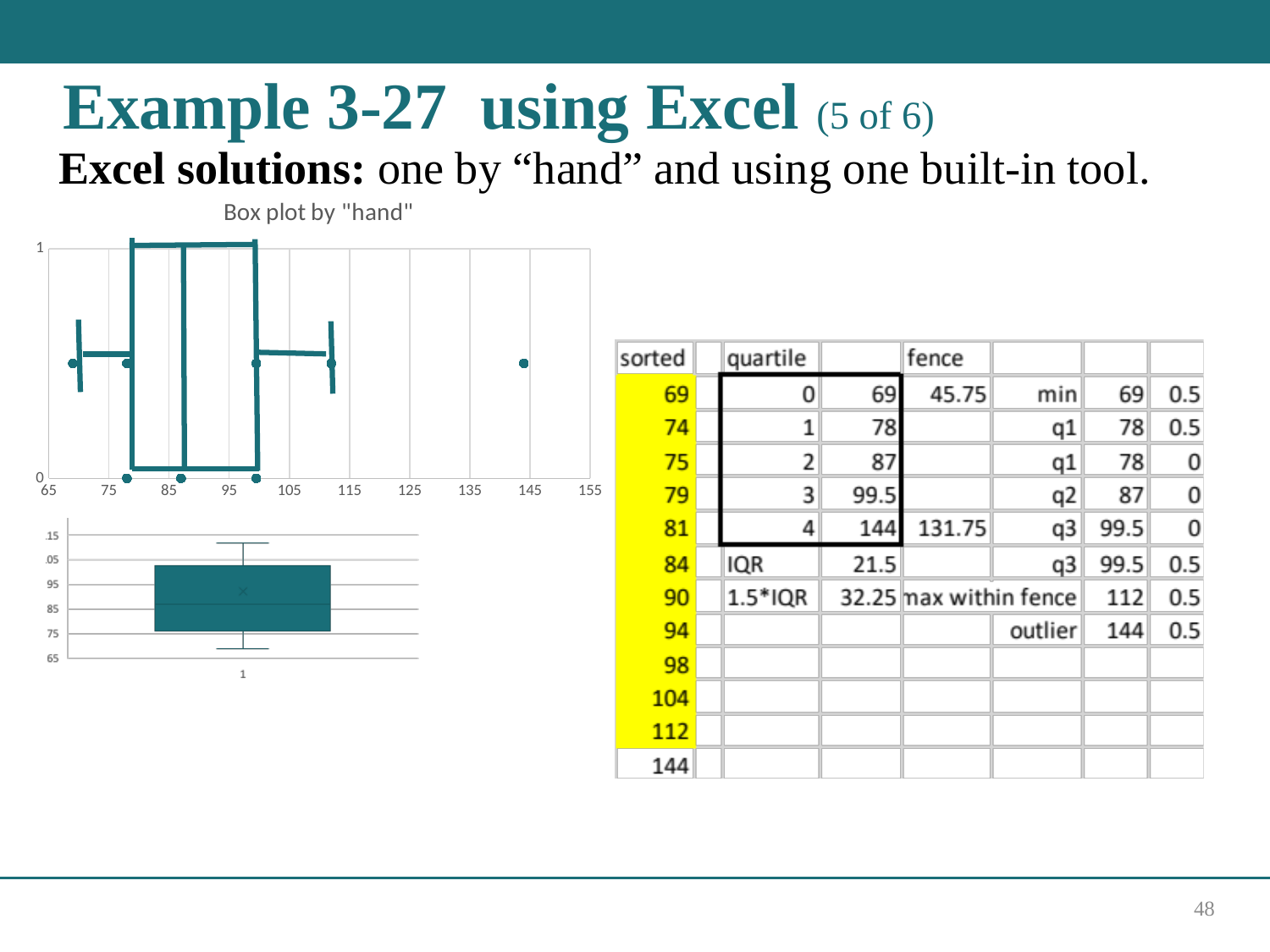
In the top chart titled Box plot by "hand", is the left end of the lower whisker greater or less than 75? less In the top chart titled Box plot by "hand", is the isolated outlier point greater or less than 135? greater In the top chart titled Box plot by "hand", what is the lowest value shown on the x axis? 65 In the top chart titled Box plot by "hand", is the left edge of the box greater or less than 75? greater In the top chart titled Box plot by "hand", what is the highest value shown on the x axis? 155 In the top chart titled Box plot by "hand", how many outlier points are plotted beyond the upper whisker? 1 What is the title of the top chart on the slide? Box plot by "hand" What kind of chart is the top chart titled Box plot by "hand"? box plot